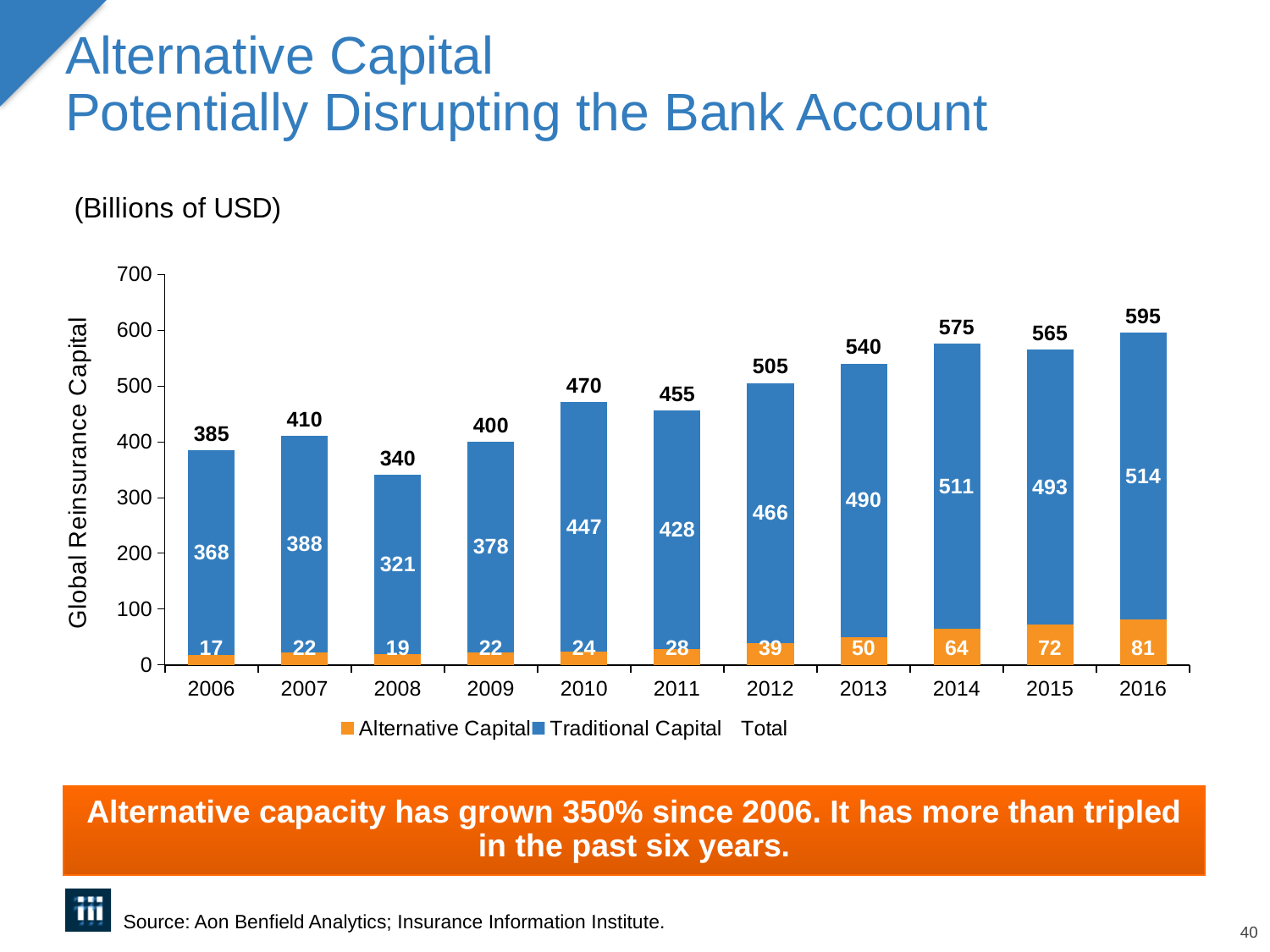
What is the difference between the Total for 2016 and the Total for 2006? 210 Which is larger, the Traditional Capital value for 2014 or for 2015? 2014 What is the Alternative Capital value for 2016? 81 Which year has the highest Total? 2016 Which year has the lowest Total? 2008 Is the Total for 2012 greater or less than 500? greater What kind of chart is shown on the slide? Stacked bar chart How many series does the legend list? 3 What is the Total value for 2013? 540 How many years are shown on the x axis? 11 Does the Alternative Capital value rise or fall from 2011 to 2016? Rise What is the Traditional Capital value for 2010? 447